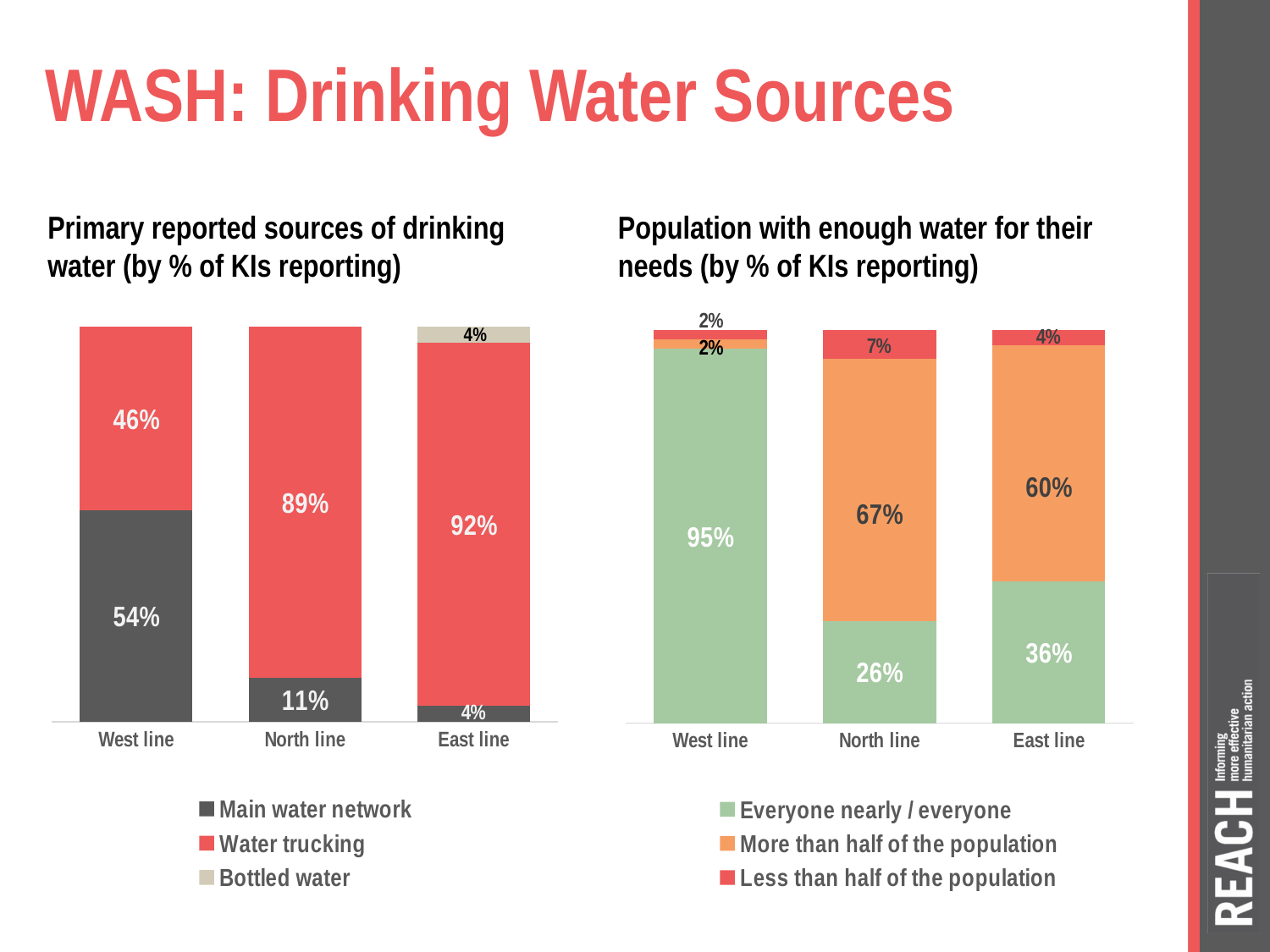
What type of chart is used on the right side of the slide? Stacked bar chart In the 'Primary reported sources of drinking water' chart, what percentage of KIs in North line reported water trucking? 89% In the 'Primary reported sources of drinking water' chart, how many series does the legend list? 3 In the 'Population with enough water for their needs' chart, what is the total of the East line stacked bar? 100% In the 'Population with enough water for their needs' chart, is the 'Less than half of the population' value larger for North line or East line? North line In the 'Primary reported sources of drinking water' chart, what percentage of KIs in East line reported bottled water? 4% In the 'Population with enough water for their needs' chart, what percentage of KIs in West line reported everyone / nearly everyone has enough water? 95% In the 'Population with enough water for their needs' chart, which line has the lowest percentage reporting everyone / nearly everyone has enough water? North line In the 'Primary reported sources of drinking water' chart, which line has the highest percentage reporting water trucking? East line In the 'Population with enough water for their needs' chart, what percentage of KIs in North line reported more than half of the population has enough water? 67% In the 'Primary reported sources of drinking water' chart, what is the difference between the main water network percentages for West line and North line? 43% In the 'Primary reported sources of drinking water' chart, what percentage of KIs in West line reported the main water network? 54%